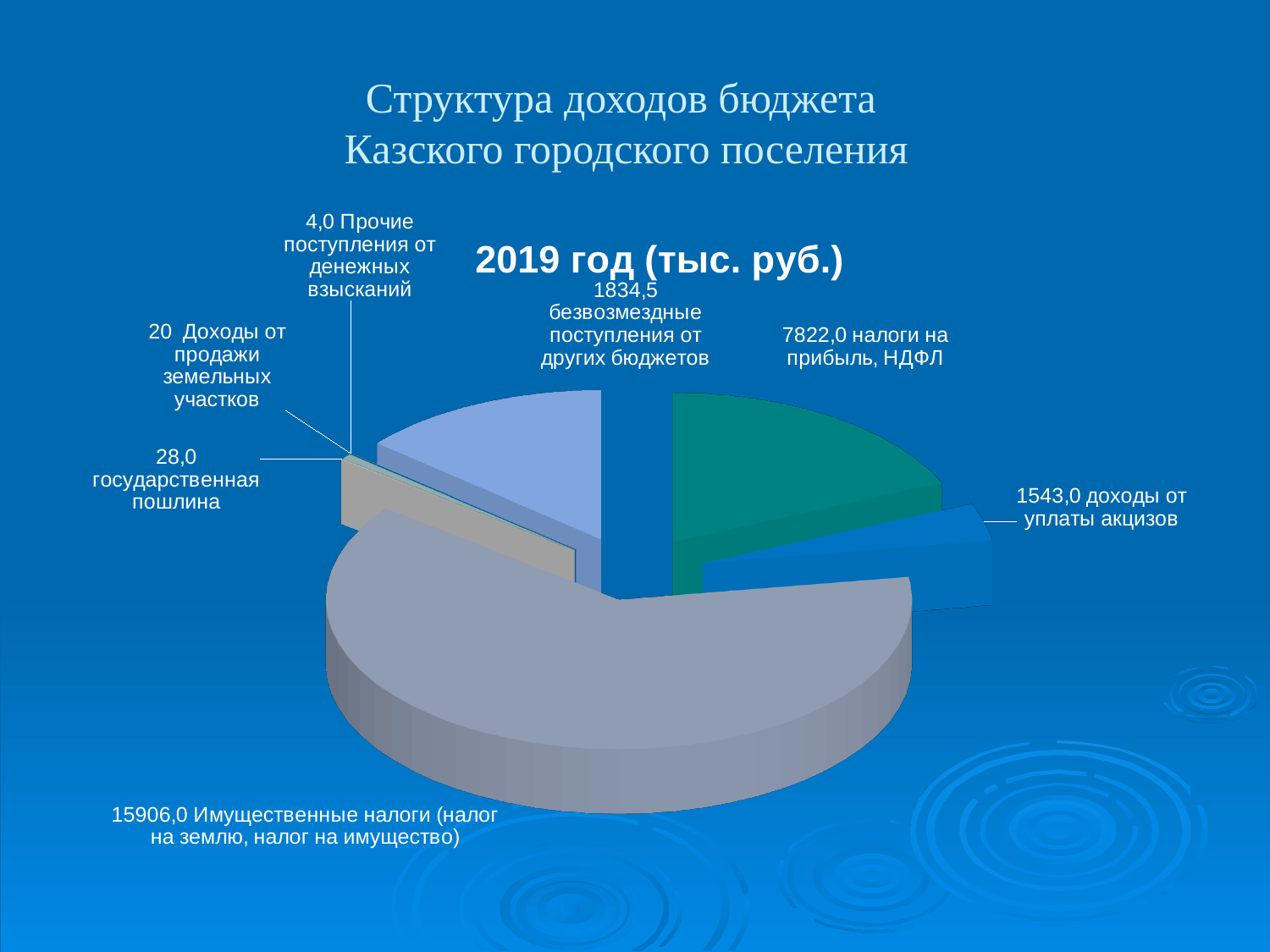
What is the value for "налоги на прибыль, НДФЛ"? 7822,0 What is the title of the chart? 2019 год (тыс. руб.) What is the value for "безвозмездные поступления от других бюджетов"? 1834,5 What is the value for "государственная пошлина"? 28,0 What is the value for "Имущественные налоги (налог на землю, налог на имущество)"? 15906,0 Which is larger: "безвозмездные поступления от других бюджетов" or "доходы от уплаты акцизов"? безвозмездные поступления от других бюджетов What is the difference between "Имущественные налоги" and "налоги на прибыль, НДФЛ"? 8084,0 What type of chart is shown on the slide? Pie chart What is the difference between "безвозмездные поступления от других бюджетов" and "доходы от уплаты акцизов"? 291,5 Which category has the smallest value? Прочие поступления от денежных взысканий Which category has the largest value? Имущественные налоги (налог на землю, налог на имущество)